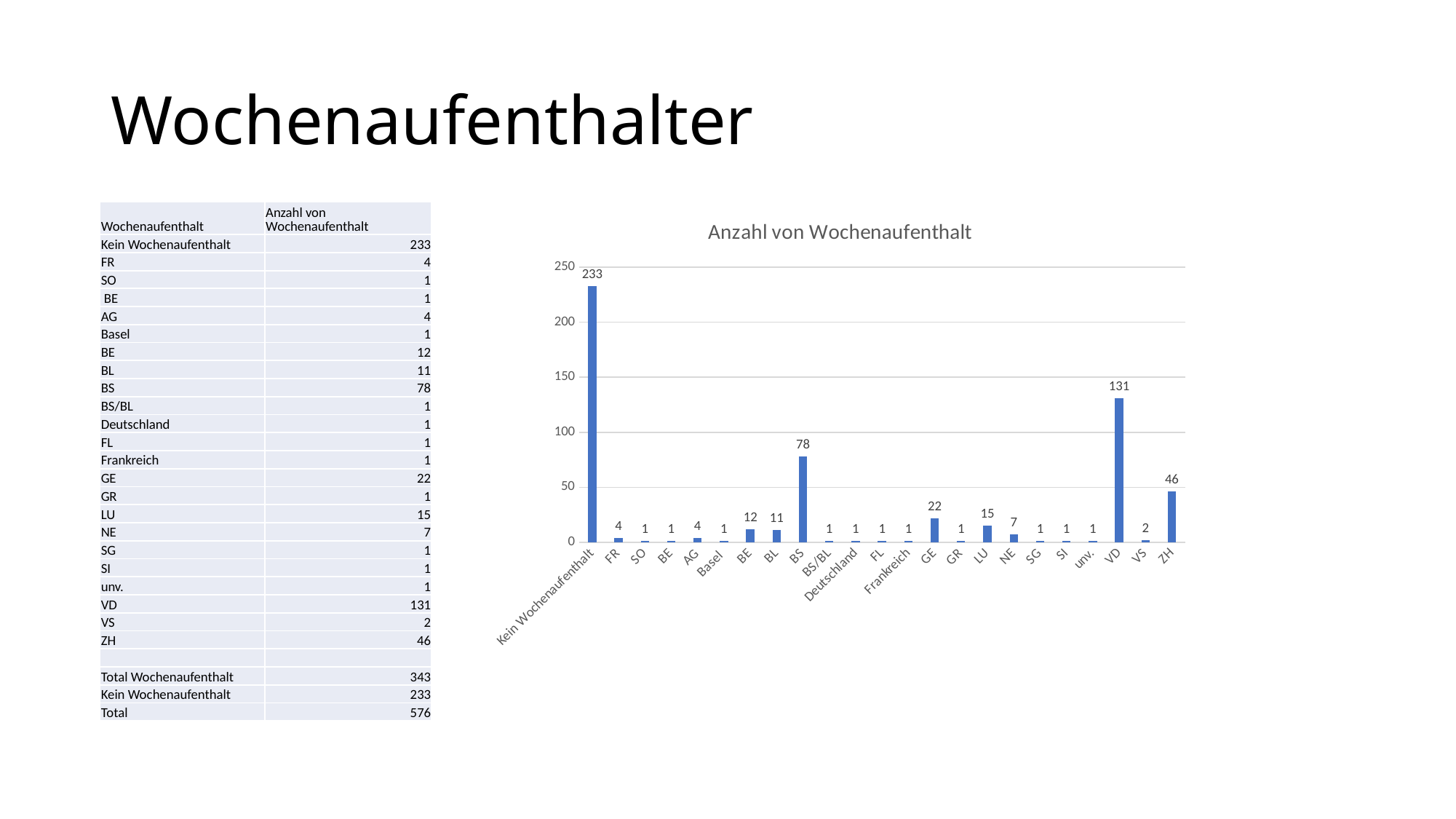
What is the value for BS in the chart? 78 What is the difference between the values for BS and ZH? 32 What is the value for VD in the chart? 131 Which is larger, the value for LU or the value for NE? LU How many categories are shown on the x axis of the chart? 23 What is the difference between the values for Kein Wochenaufenthalt and VD? 102 Is the value for VD greater or less than 100? greater What is the title of the chart? Anzahl von Wochenaufenthalt Which category has the highest value in the chart? Kein Wochenaufenthalt What kind of chart is shown on the slide? bar chart What is the value for ZH in the chart? 46 What is the value for GE in the chart? 22